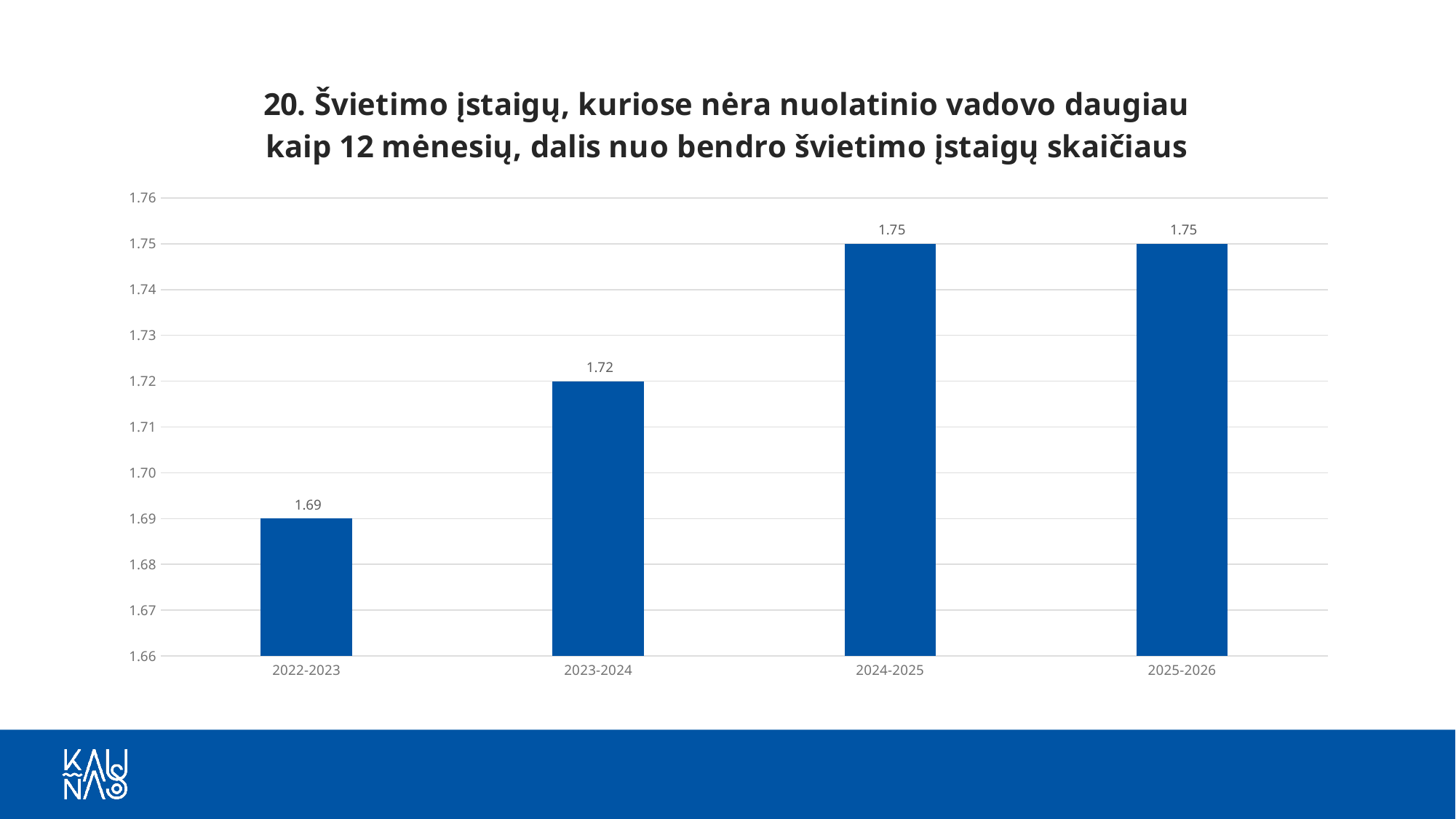
Which is larger, the value for 2023-2024 or the value for 2022-2023? 2023-2024 What is the difference between the values for 2024-2025 and 2023-2024? 0.03 What is the value for 2022-2023? 1.69 What is the difference between the values for 2023-2024 and 2022-2023? 0.03 How many categories are shown on the x axis? 4 Which category has the lowest value? 2022-2023 What is the value for 2024-2025? 1.75 What is the value for 2025-2026? 1.75 What is the value for 2023-2024? 1.72 What kind of chart is shown on the slide? bar chart Is the value for 2023-2024 greater or less than 1.70? greater Do the values rise or fall from 2022-2023 to 2024-2025? rise